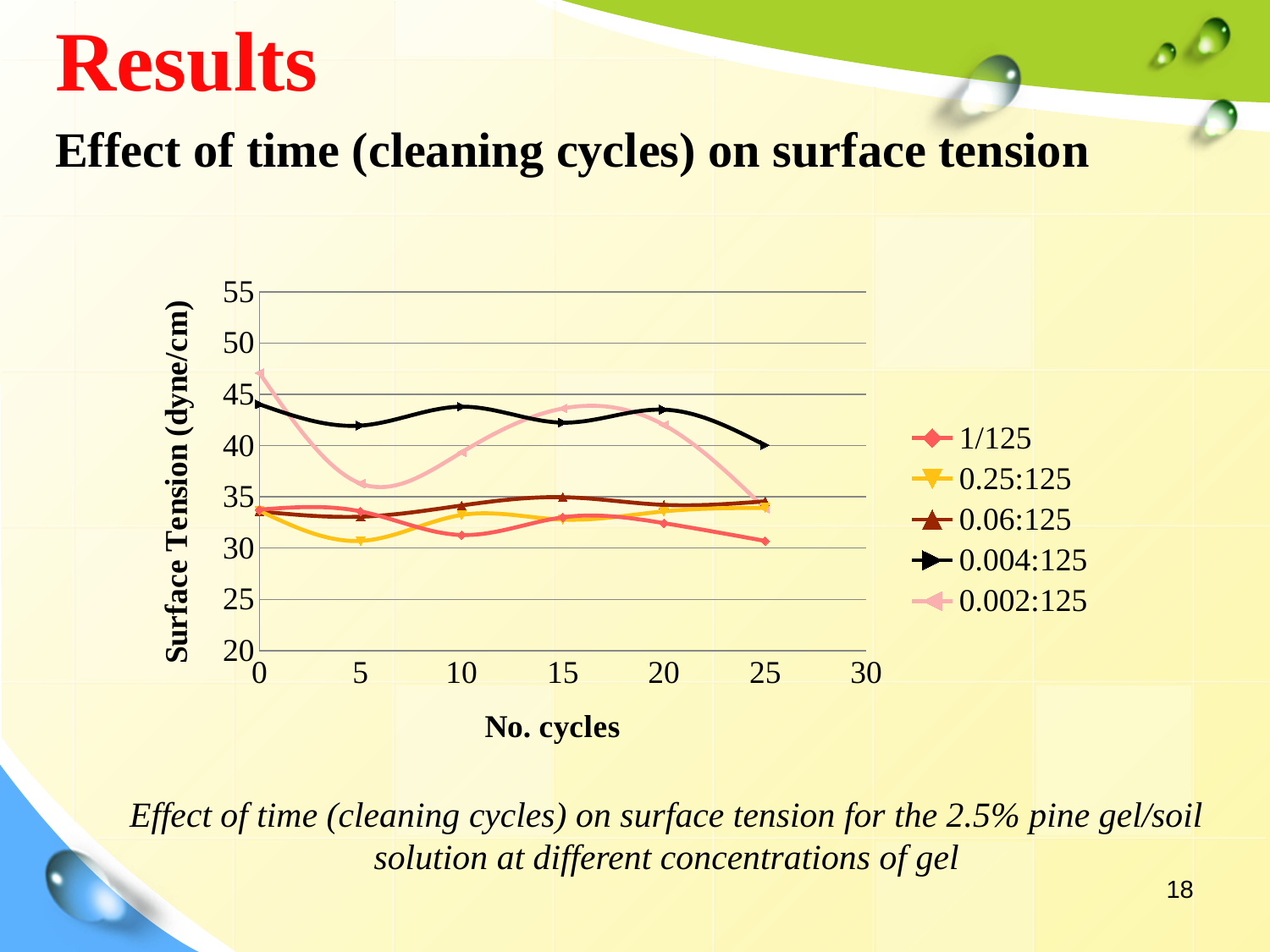
What kind of chart is shown on the slide? line chart What is the title of the vertical axis? Surface Tension (dyne/cm) Is the value for 0.002:125 at 0 cycles greater or less than 45? greater How many series does the legend list? 5 Is the value for 1/125 at 25 cycles greater or less than 35? less Does the value for 0.002:125 rise or fall between 0 and 5 cycles? fall Is the value for 0.004:125 at 0 cycles greater or less than 40? greater Which series has the highest surface tension at 25 cycles? 0.004:125 How many data points are plotted for the 0.004:125 series? 6 At 10 cycles, which is larger: the value for 0.002:125 or the value for 0.06:125? 0.002:125 Which series has the lowest surface tension at 25 cycles? 1/125 What is the title of the horizontal axis? No. cycles